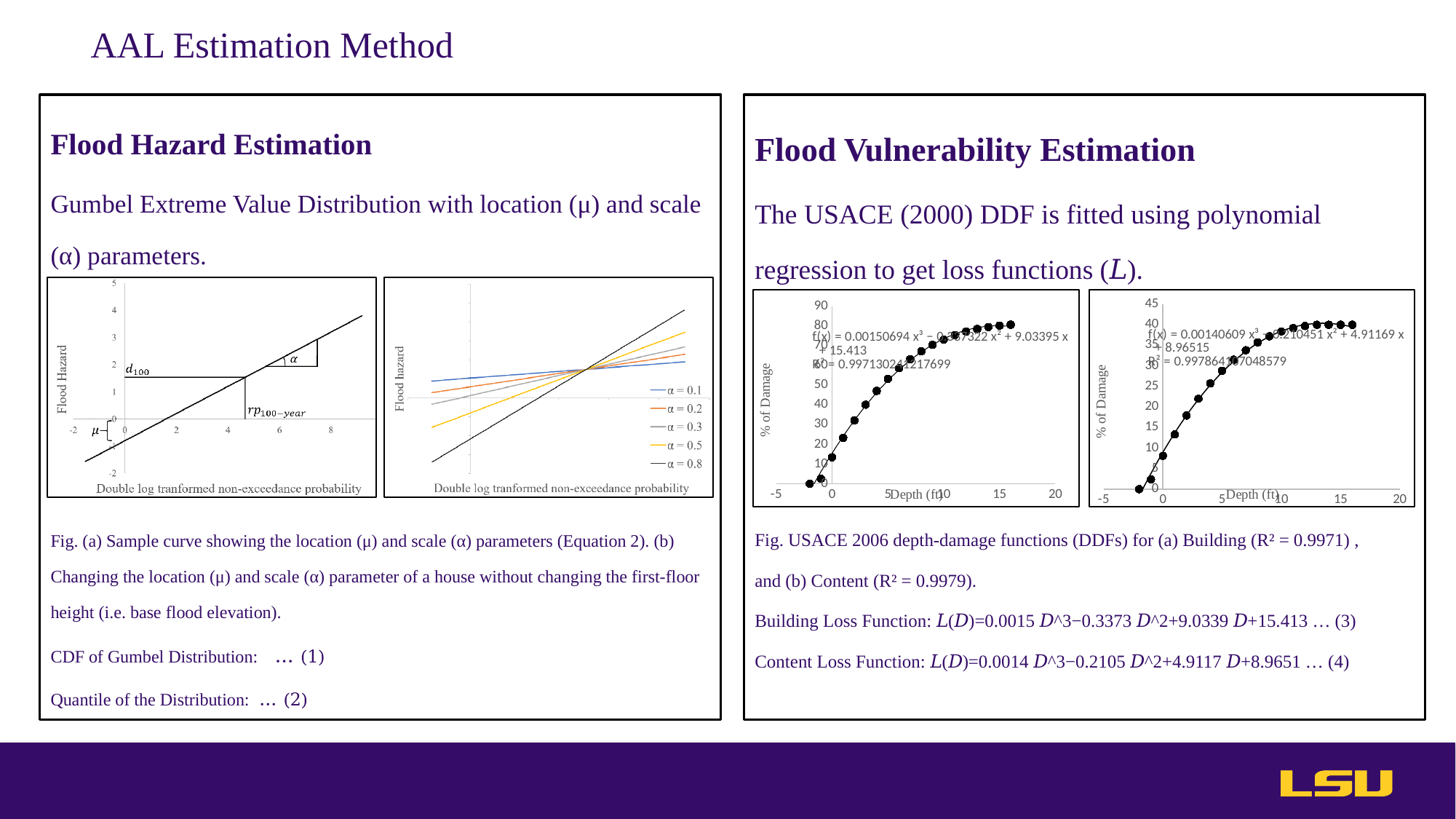
In the right-hand chart of the Flood Hazard Estimation panel, what is the label of the y axis? Flood hazard In the right-hand chart of the Flood Hazard Estimation panel, which α value has the flattest line? α = 0.1 In the Content DDF chart (right chart of the Flood Vulnerability Estimation panel), does the % of Damage rise or fall as Depth increases? rise In the Building DDF chart (left chart of the Flood Vulnerability Estimation panel), is the % of Damage at a depth of 15 ft greater or less than 70? greater What is the highest value shown on the y axis of the Content DDF chart (right chart of the Flood Vulnerability Estimation panel)? 45 In the Building DDF chart (left chart of the Flood Vulnerability Estimation panel), is the % of Damage at a depth of 0 ft greater or less than 30? less In the Building DDF chart (left chart of the Flood Vulnerability Estimation panel), does the % of Damage rise or fall as Depth increases? rise In the right-hand chart of the Flood Hazard Estimation panel, which α value has the steepest line? α = 0.8 In the right-hand chart of the Flood Hazard Estimation panel (the one with the legend), how many series does the legend list? 5 In the right-hand chart of the Flood Hazard Estimation panel, which α value is shown by the black line? α = 0.8 In the Content DDF chart (right chart of the Flood Vulnerability Estimation panel), is the % of Damage at a depth of 15 ft greater or less than 35? greater